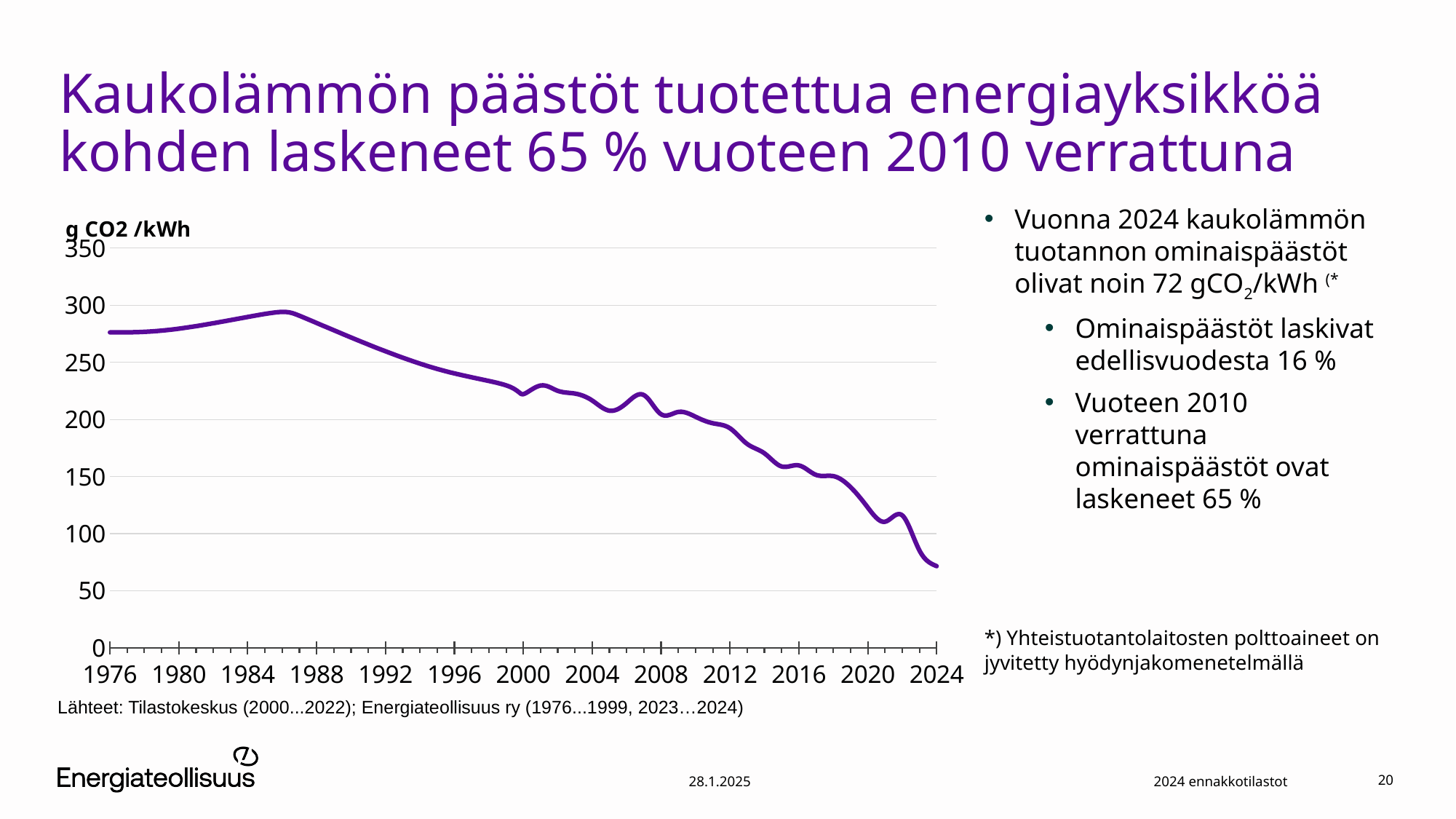
Which is larger, the value for 1976 or the value for 2024? 1976 What kind of chart is shown on the slide? line chart Is the value for 2024 greater or less than 100? less Is the value for 1976 greater or less than 250? greater Is the value for 2000 greater or less than 200? greater Do the values in the chart generally rise or fall from 1976 to 2024? fall What unit label is shown above the vertical axis of the chart? g CO2 /kWh Which year has the lowest value in the chart? 2024 Which is larger, the value for 2008 or the value for 2016? 2008